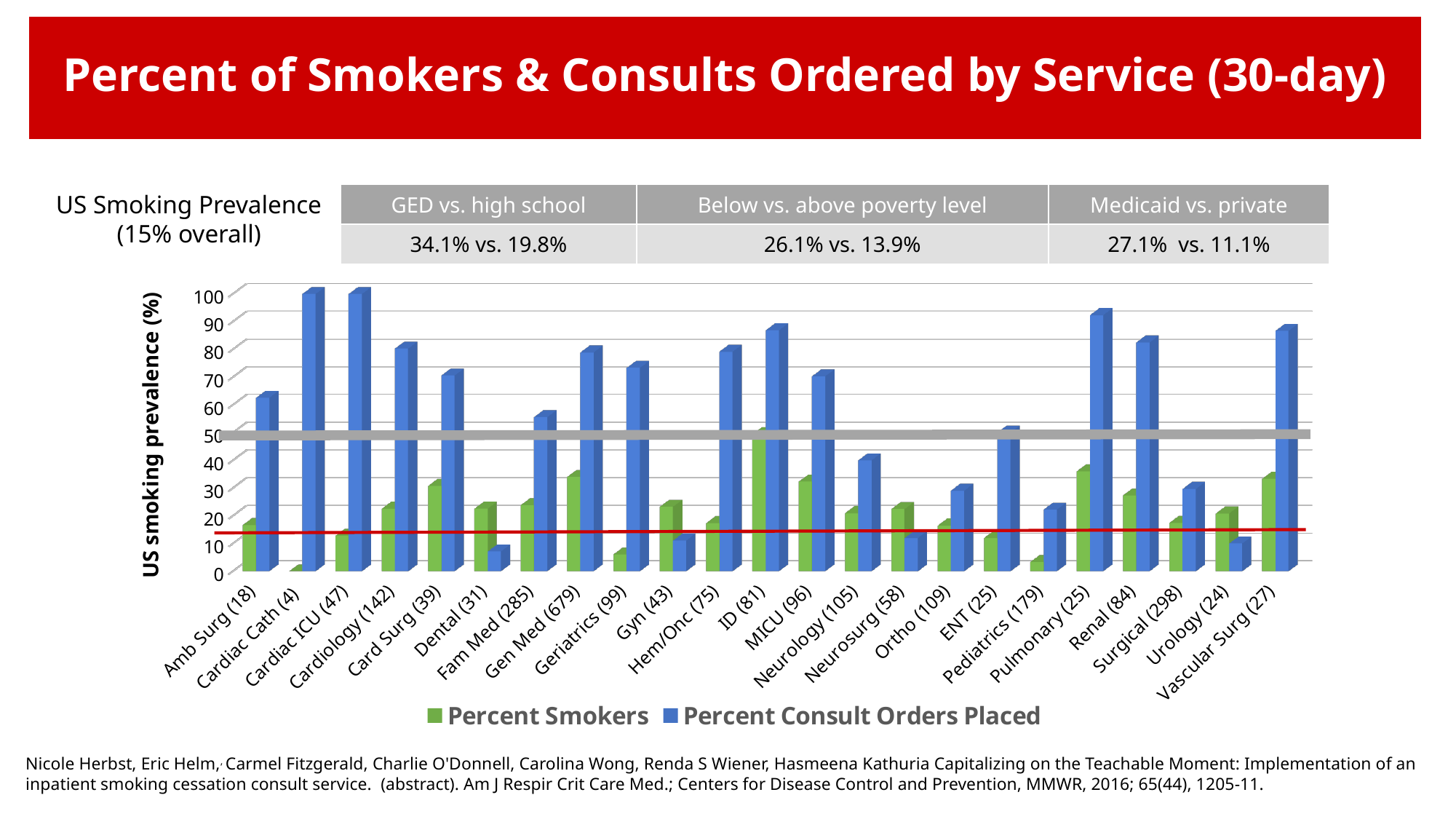
What colour represents the Percent Smokers series in the chart? green Which service has the lowest Percent Smokers value? Cardiac Cath (4) Which is larger: the Percent Consult Orders Placed value for Gen Med (679) or for Dental (31)? Gen Med (679) What is the Percent Consult Orders Placed value for Cardiac ICU (47)? 100 What kind of chart is shown on the slide? bar chart Which service has the highest Percent Smokers value? ID (81) Is the Percent Consult Orders Placed value for Dental (31) greater or less than 20? less What is the Percent Consult Orders Placed value for Cardiac Cath (4)? 100 How many series does the chart legend list? 2 How many services (categories) are shown on the x axis of the chart? 23 Is the Percent Consult Orders Placed value for Pulmonary (25) greater or less than 80? greater Is the Percent Smokers value for Gen Med (679) greater or less than 30? greater